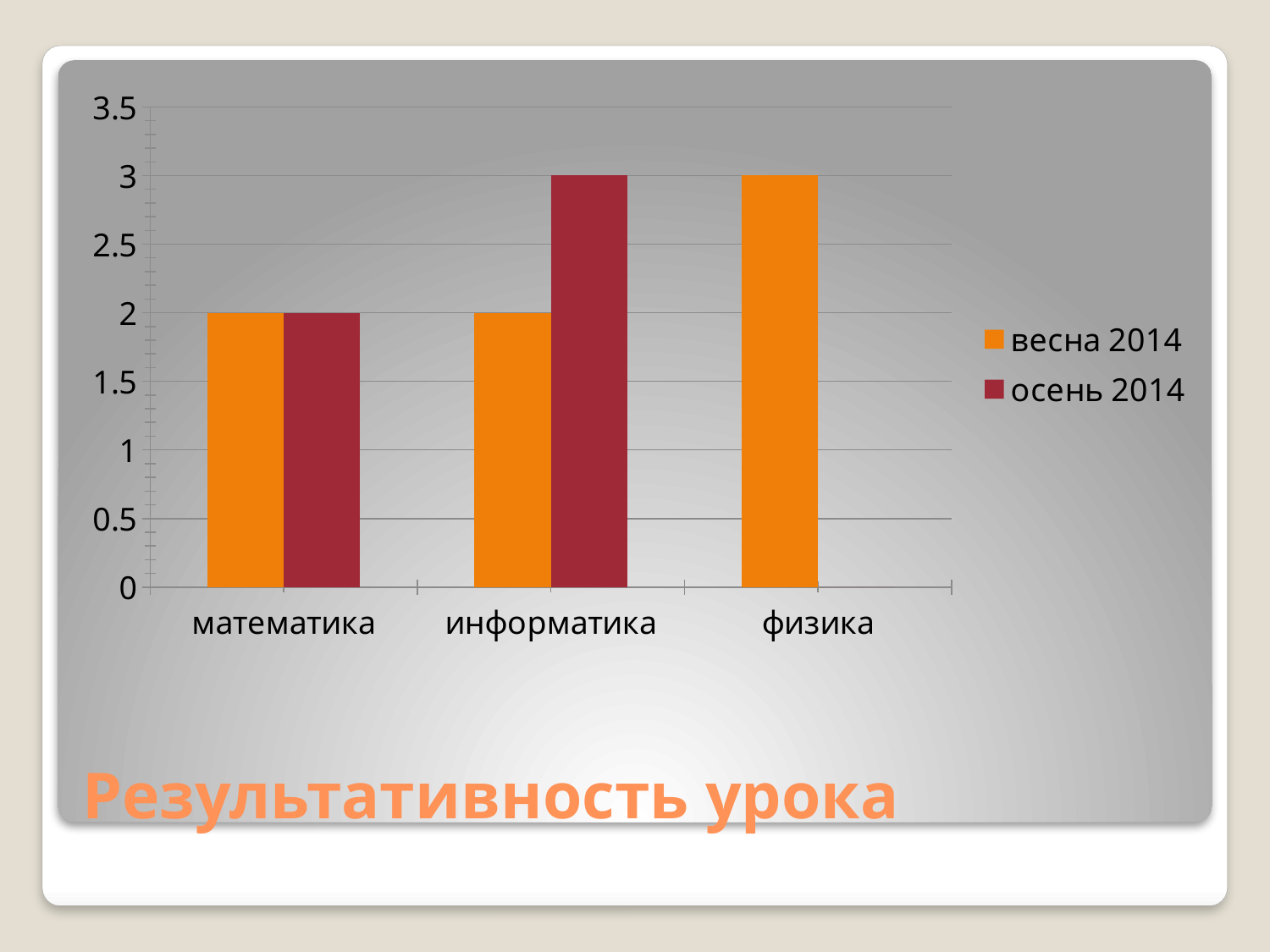
What kind of chart is shown on the slide? bar chart How many series does the legend list? 2 What is the value for математика in the весна 2014 series? 2 Which is larger for информатика: the весна 2014 value or the осень 2014 value? осень 2014 Which category has the highest value in the осень 2014 series? информатика What is the value for математика in the осень 2014 series? 2 What is the value for физика in the весна 2014 series? 3 What is the value for информатика in the осень 2014 series? 3 What is the title of the chart? Результативность урока Which category has the highest value in the весна 2014 series? физика What is the difference between the осень 2014 and весна 2014 values for информатика? 1 How many categories are shown on the x axis? 3